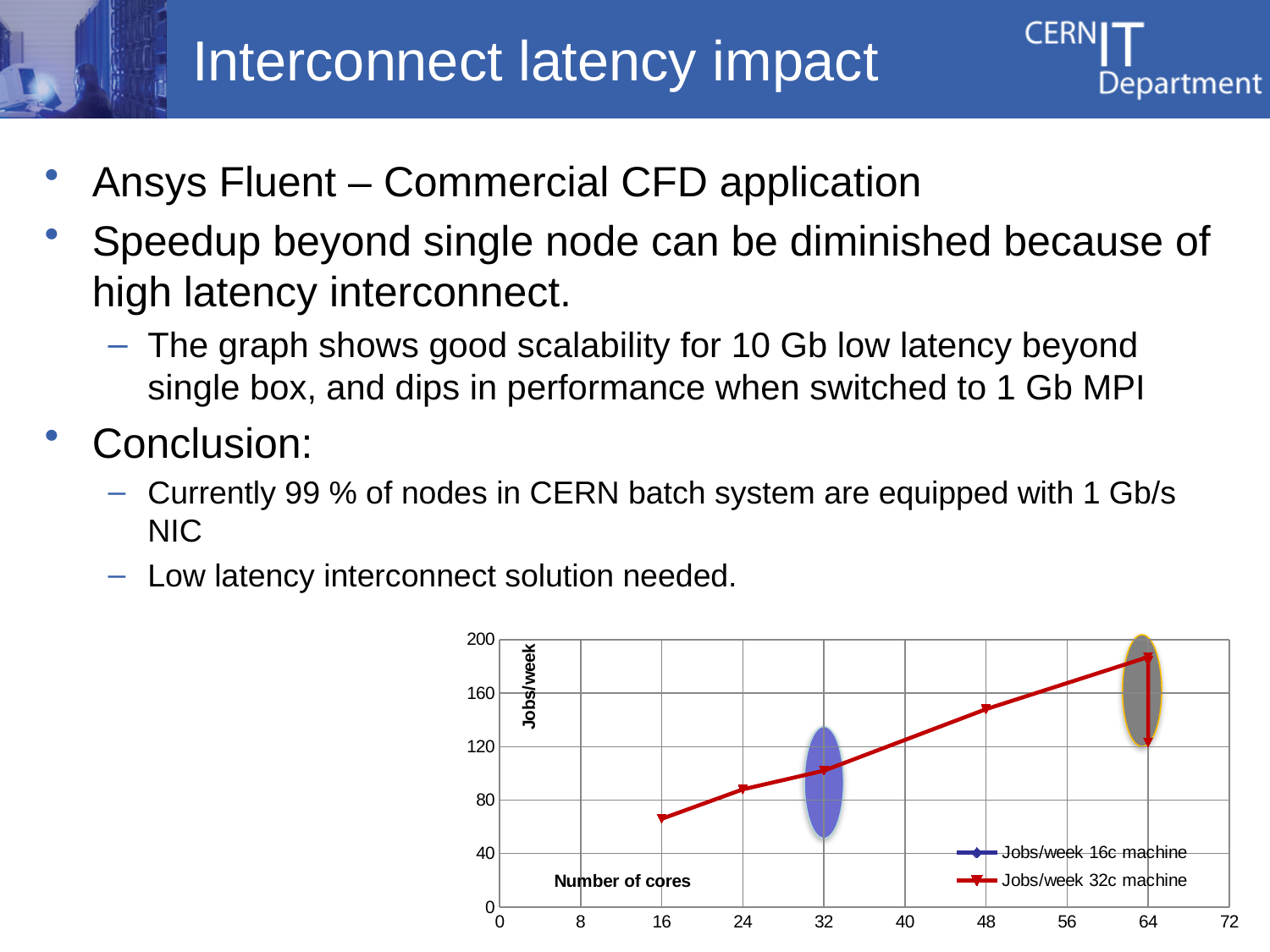
Is the Jobs/week value at 48 cores greater or less than 160? less Between 16 and 48 cores, does the Jobs/week value rise or fall as the number of cores increases? rise Is the Jobs/week value at 24 cores greater or less than 80? greater Is the Jobs/week value at 32 cores greater or less than 120? less What is the label of the y axis of the chart? Jobs/week How many series does the chart legend list? 2 What kind of chart is shown on the slide? line chart What is the label of the x axis of the chart? Number of cores